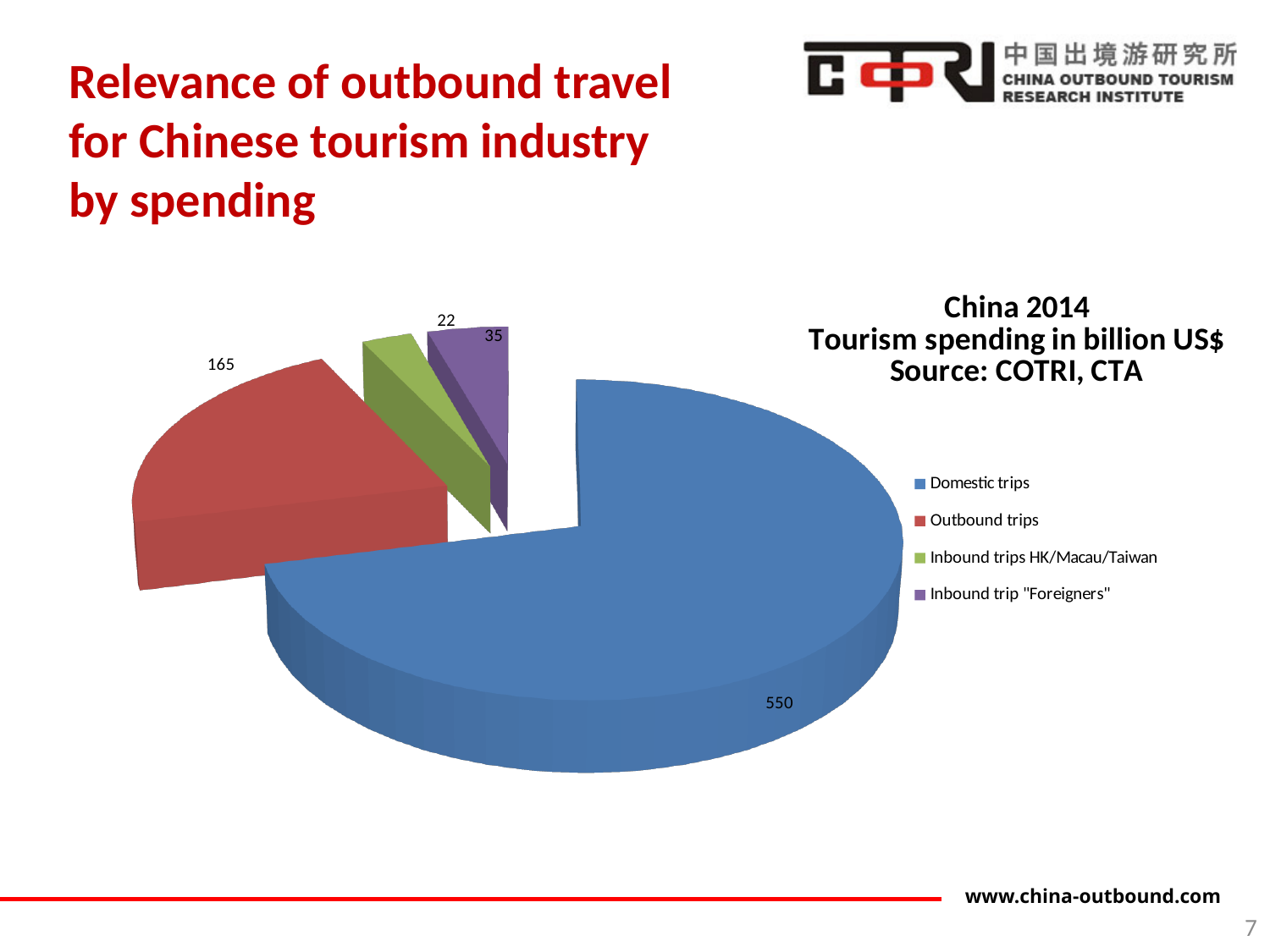
Which category has the smallest tourism spending? Inbound trips HK/Macau/Taiwan In what unit is tourism spending shown in the chart? billion US$ What share of total tourism spending do Domestic trips represent, to the nearest whole percent? 71% What is the value shown for Inbound trip "Foreigners"? 35 How many categories does the pie chart show? 4 What is the tourism spending value for Domestic trips? 550 Which is larger, the value for Outbound trips or the value for Inbound trip "Foreigners"? Outbound trips What is the value shown for Inbound trips HK/Macau/Taiwan? 22 What kind of chart is shown on the slide? Pie chart Which category has the largest tourism spending? Domestic trips What is the tourism spending value for Outbound trips? 165 What is the difference between the Domestic trips value and the Outbound trips value? 385